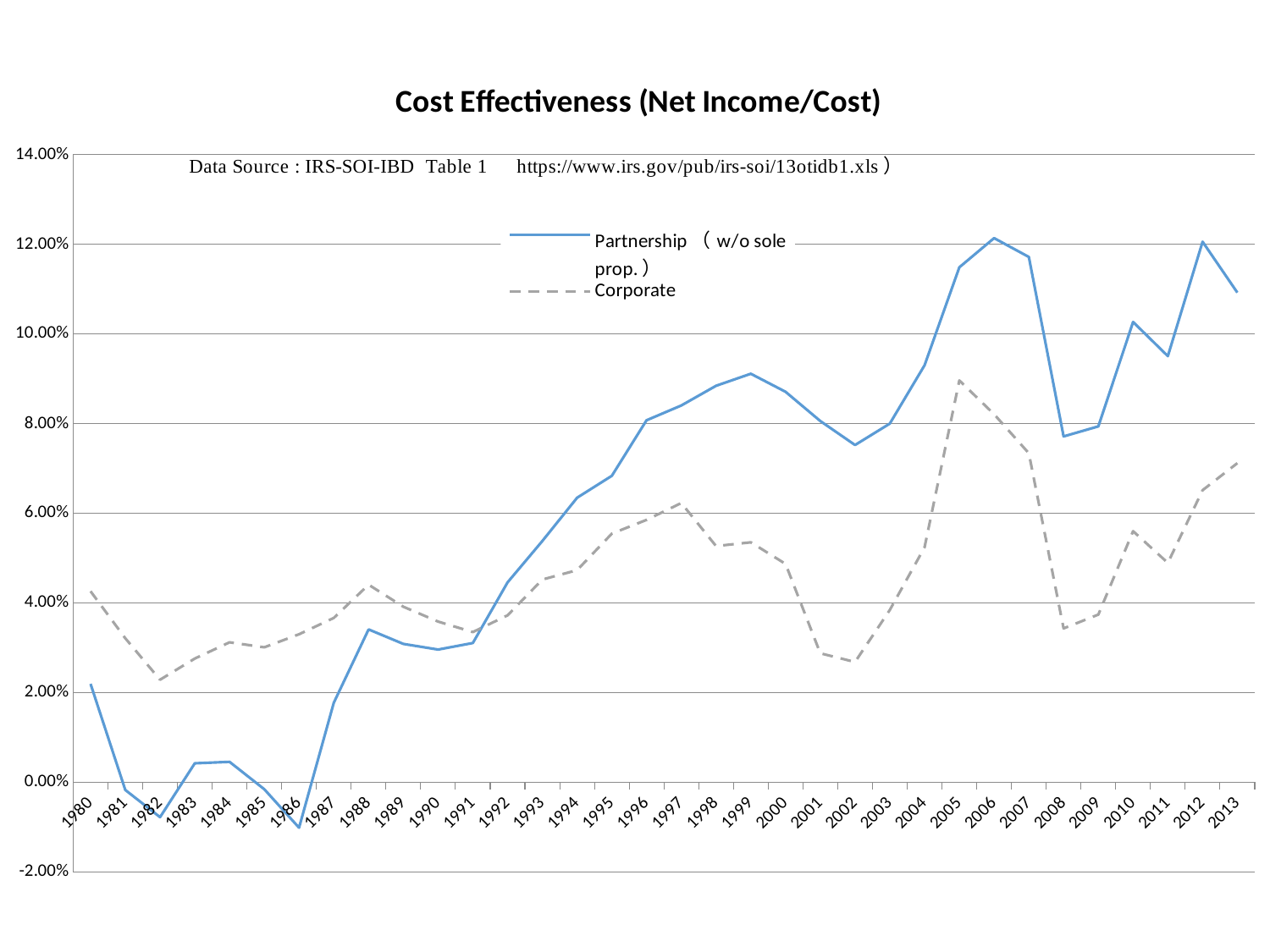
In 1980, which series has the higher value, Partnership (w/o sole prop.) or Corporate? Corporate What kind of chart is shown on the slide? line chart In 2005, which series has the higher value, Partnership (w/o sole prop.) or Corporate? Partnership (w/o sole prop.) Is the Corporate value for 2001 greater or less than 4.00%? less Is the Partnership (w/o sole prop.) value for 1986 greater or less than 0.00%? less Does the Partnership (w/o sole prop.) series generally rise or fall from 1986 to 1999? rise What is the title of the chart? Cost Effectiveness (Net Income/Cost) In which year is the Corporate series at its highest? 2005 Is the Partnership (w/o sole prop.) value for 2005 greater or less than 10.00%? greater How many series does the legend list? 2 How many years are plotted along the x axis? 34 In which year is the Partnership (w/o sole prop.) series at its lowest? 1986